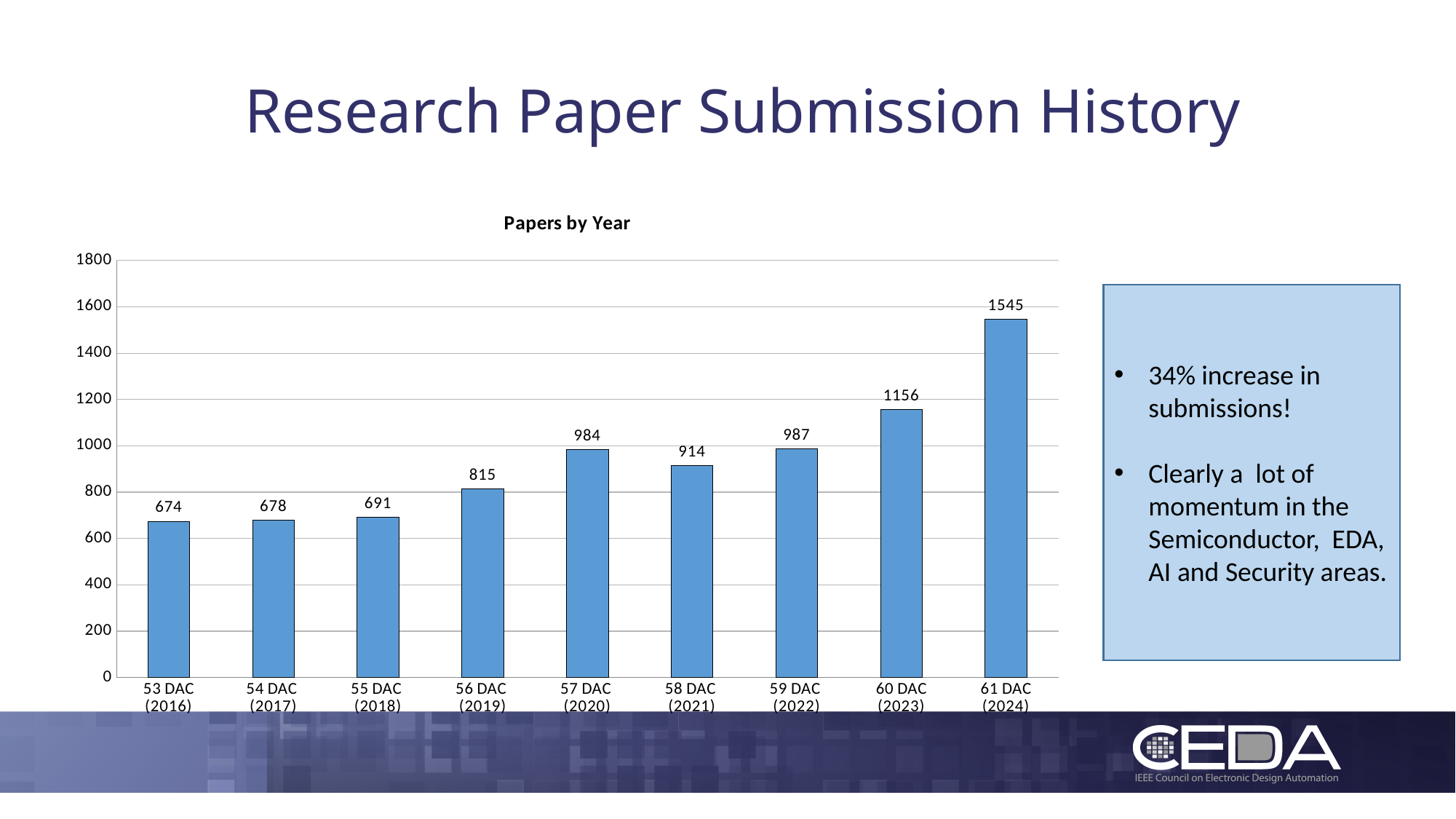
What is the value for 58 DAC (2021)? 914 Which category has the highest value? 61 DAC (2024) What is the title of the chart? Papers by Year How many categories are shown on the x axis? 9 What is the difference between the values for 61 DAC (2024) and 60 DAC (2023)? 389 Which is larger, the value for 57 DAC (2020) or 58 DAC (2021)? 57 DAC (2020) Is the value for 60 DAC (2023) greater or less than 1000? greater What is the value for 56 DAC (2019)? 815 What kind of chart is this? bar chart What is the value for 61 DAC (2024)? 1545 Do the values generally rise or fall from 53 DAC (2016) to 61 DAC (2024)? rise Which category has the lowest value? 53 DAC (2016)